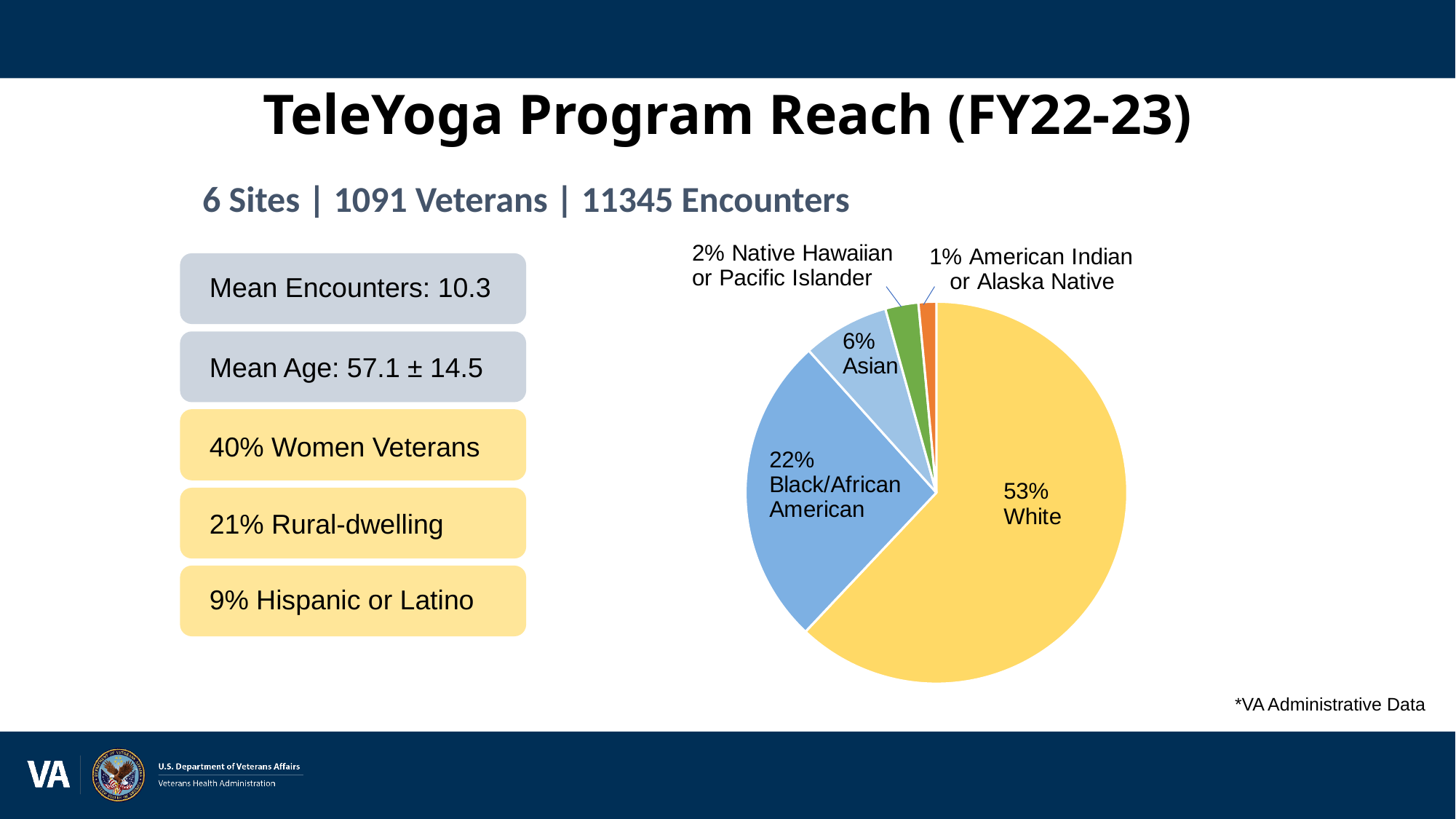
Which slice is larger, Asian or Native Hawaiian or Pacific Islander? Asian What kind of chart is shown on the slide? Pie chart What share of the pie chart is Black/African American? 22% Which slice of the pie chart is the largest? White What is the difference in percentage points between the White and Black/African American slices? 31 What share of the pie chart is Native Hawaiian or Pacific Islander? 2% What share of the pie chart is American Indian or Alaska Native? 1% Which slice of the pie chart is the smallest? American Indian or Alaska Native What colour is the White slice of the pie chart? Yellow How many slices does the pie chart have? 5